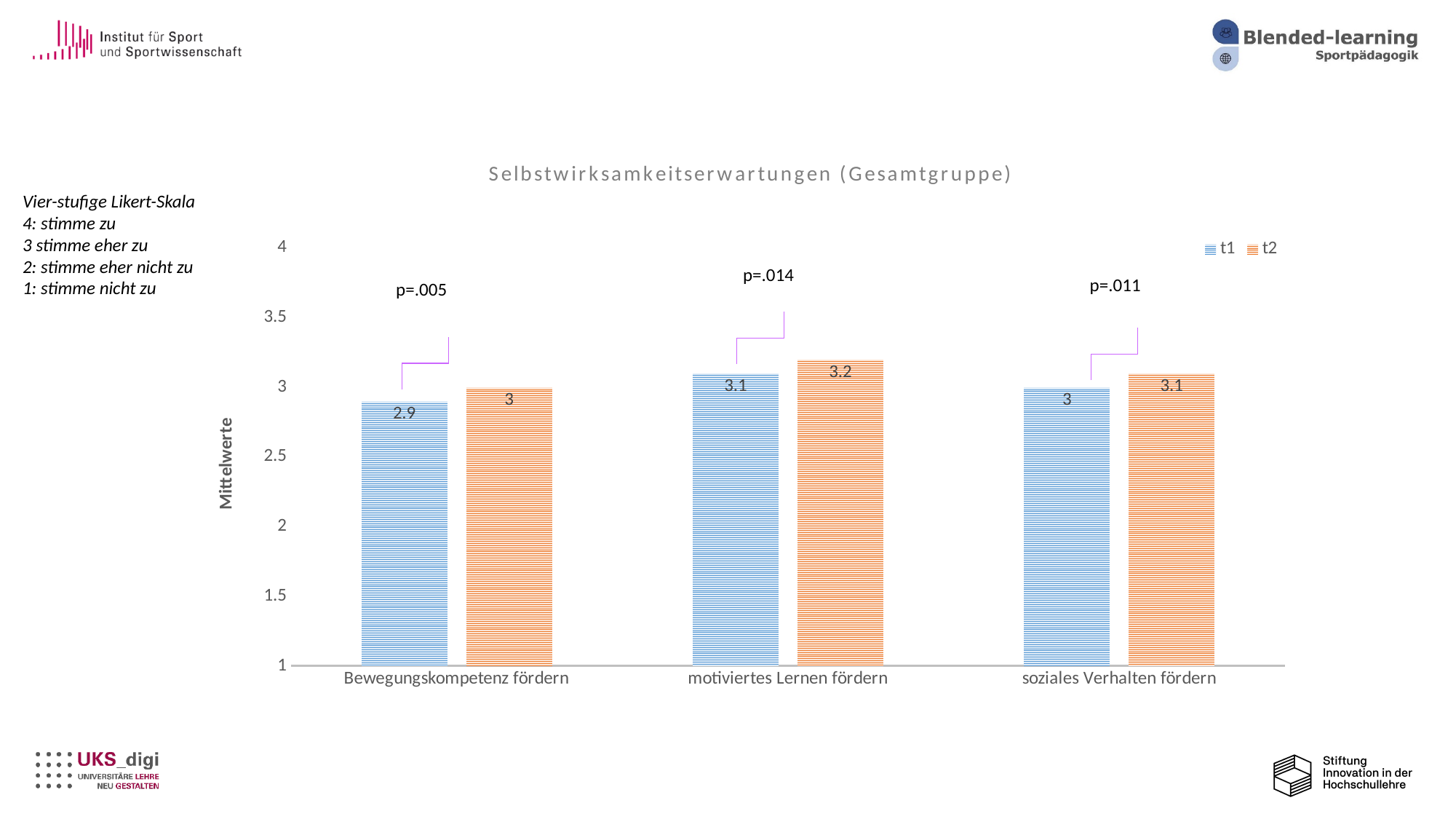
Which category has the highest t2 value? motiviertes Lernen fördern How many categories are shown on the x axis? 3 Which category has the lowest t1 value? Bewegungskompetenz fördern What is the t2 value for motiviertes Lernen fördern? 3.2 What is the difference between the t2 and t1 values for motiviertes Lernen fördern? 0.1 What kind of chart is shown on the slide? bar chart What is the label of the vertical axis? Mittelwerte How many series does the legend list? 2 For soziales Verhalten fördern, which is larger, the t1 value or the t2 value? t2 What is the t2 value for Bewegungskompetenz fördern? 3 What is the t1 value for Bewegungskompetenz fördern? 2.9 What is the t1 value for soziales Verhalten fördern? 3